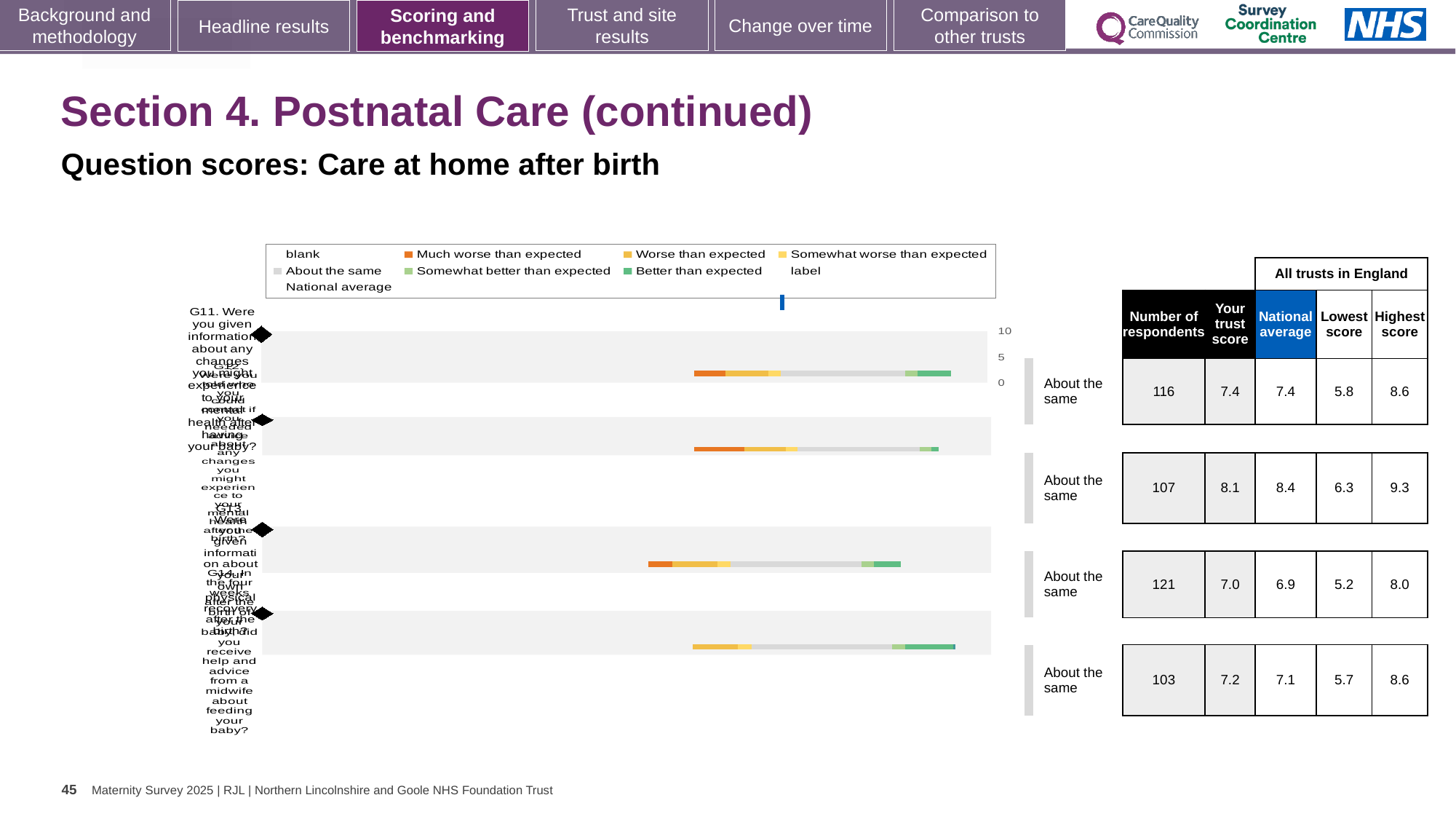
In the table beside the chart, what is the trust score for the second question row? 8.1 In the chart legend, what colour represents 'Better than expected'? green In the table beside the chart, what is the highest score for the fourth (bottom) question row? 8.6 In the chart legend, what colour represents 'Much worse than expected'? orange In the table beside the chart, what is the national average for the third question row? 6.9 Which question row has the largest number of respondents in the table beside the chart? the third row (121) In the table beside the chart, what is the number of respondents for the first (top) question row? 116 For the second question row, what is the difference between the national average and the trust score? 0.3 Which question row has the lowest 'Lowest score' value in the table beside the chart? the third row (5.2) What kind of chart is shown on the slide? bar chart How many question rows (bars) are plotted in the chart? 4 For the second question row, which is larger: the trust score or the national average? national average